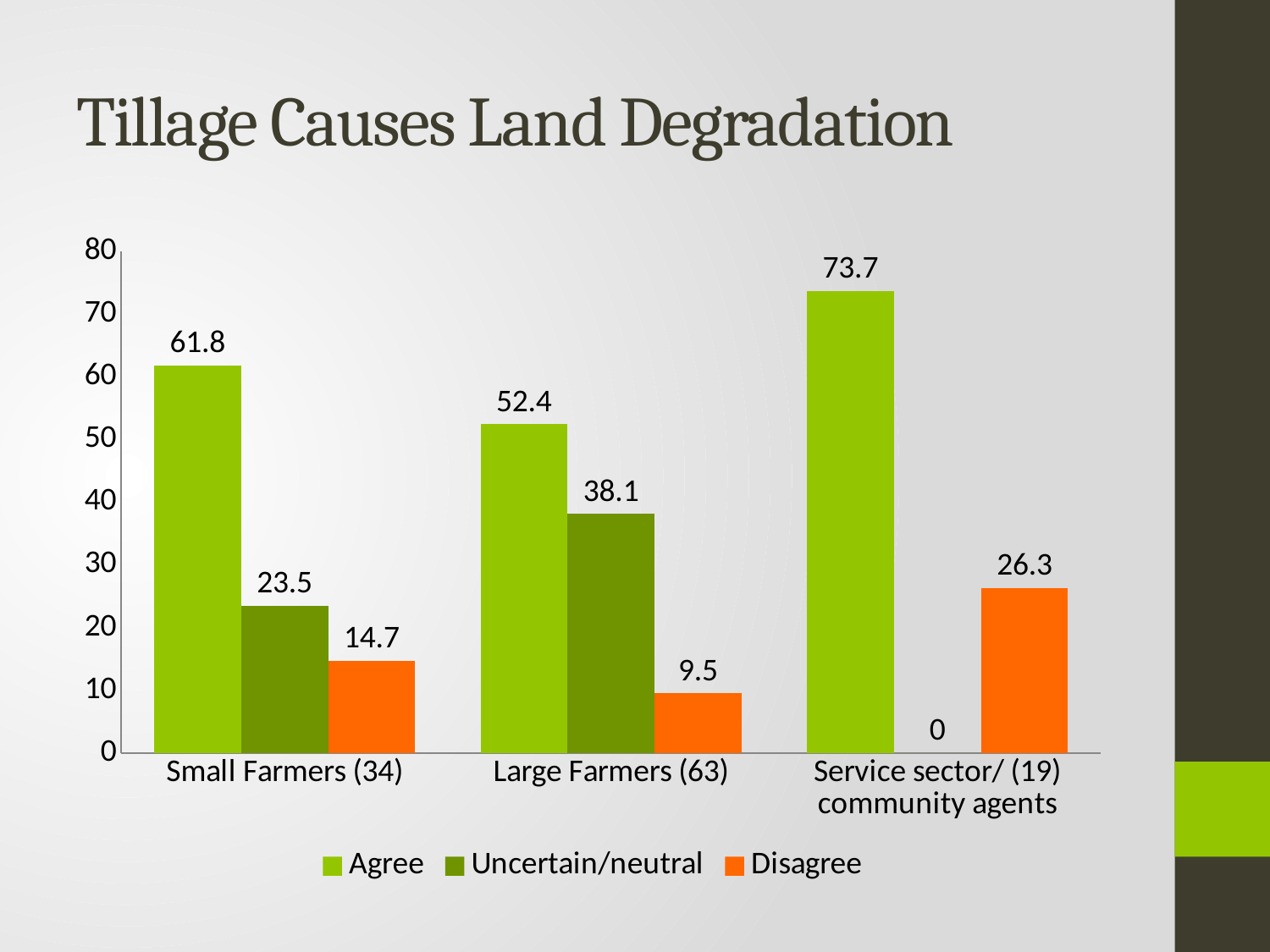
What is the difference between the Agree values for Service sector/ (19) community agents and Large Farmers (63)? 21.3 What is the Uncertain/neutral value for Large Farmers (63)? 38.1 What kind of chart is shown on the slide? bar chart What is the Disagree value for Service sector/ (19) community agents? 26.3 How many categories are shown on the x axis? 3 How many series does the legend list? 3 Which category has the highest Agree value? Service sector/ (19) community agents Is the Agree value for Large Farmers (63) greater or less than 50? greater What is the title of the slide? Tillage Causes Land Degradation What is the Agree value for Small Farmers (34)? 61.8 Which category has the lowest Disagree value? Large Farmers (63) Which is larger: the Uncertain/neutral value for Small Farmers (34) or for Large Farmers (63)? Large Farmers (63)